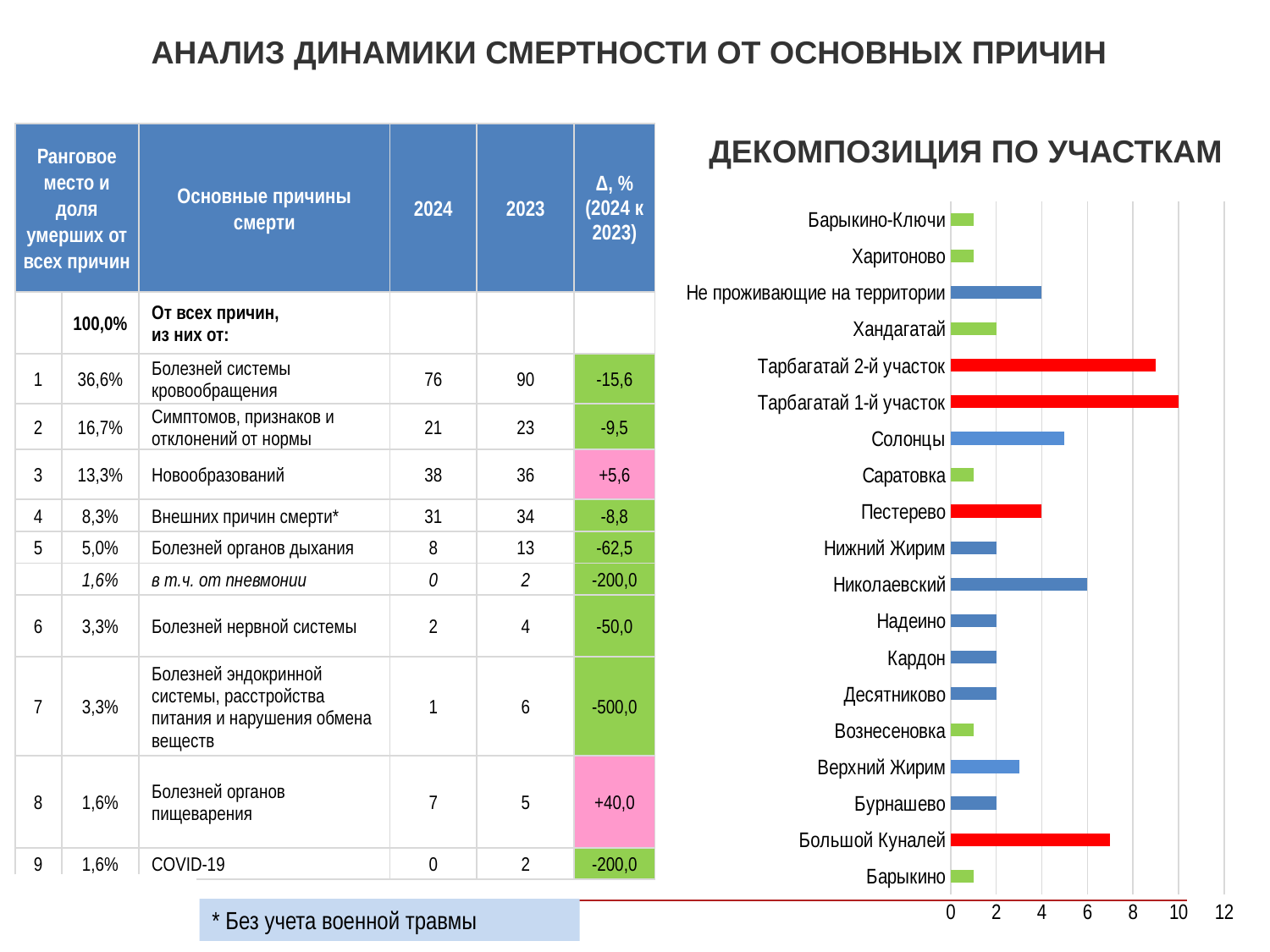
What kind of chart is shown under the title "ДЕКОМПОЗИЦИЯ ПО УЧАСТКАМ"? bar chart How many categories are shown in the "ДЕКОМПОЗИЦИЯ ПО УЧАСТКАМ" chart? 19 In the "ДЕКОМПОЗИЦИЯ ПО УЧАСТКАМ" chart, is the value for Солонцы greater or less than 4? greater In the "ДЕКОМПОЗИЦИЯ ПО УЧАСТКАМ" chart, which is larger: the value for Николаевский or the value for Пестерево? Николаевский In the "ДЕКОМПОЗИЦИЯ ПО УЧАСТКАМ" chart, what is the value for Не проживающие на территории? 4 In the "ДЕКОМПОЗИЦИЯ ПО УЧАСТКАМ" chart, is the value for Большой Куналей greater or less than 6? greater In the "ДЕКОМПОЗИЦИЯ ПО УЧАСТКАМ" chart, which category has the highest value? Тарбагатай 1-й участок In the "ДЕКОМПОЗИЦИЯ ПО УЧАСТКАМ" chart, what is the value for Пестерево? 4 In the "ДЕКОМПОЗИЦИЯ ПО УЧАСТКАМ" chart, what is the difference between the values for Тарбагатай 1-й участок and Николаевский? 4 In the "ДЕКОМПОЗИЦИЯ ПО УЧАСТКАМ" chart, is the value for Тарбагатай 2-й участок greater or less than 8? greater In the "ДЕКОМПОЗИЦИЯ ПО УЧАСТКАМ" chart, what is the value for Тарбагатай 1-й участок? 10 In the "ДЕКОМПОЗИЦИЯ ПО УЧАСТКАМ" chart, what is the value for Николаевский? 6